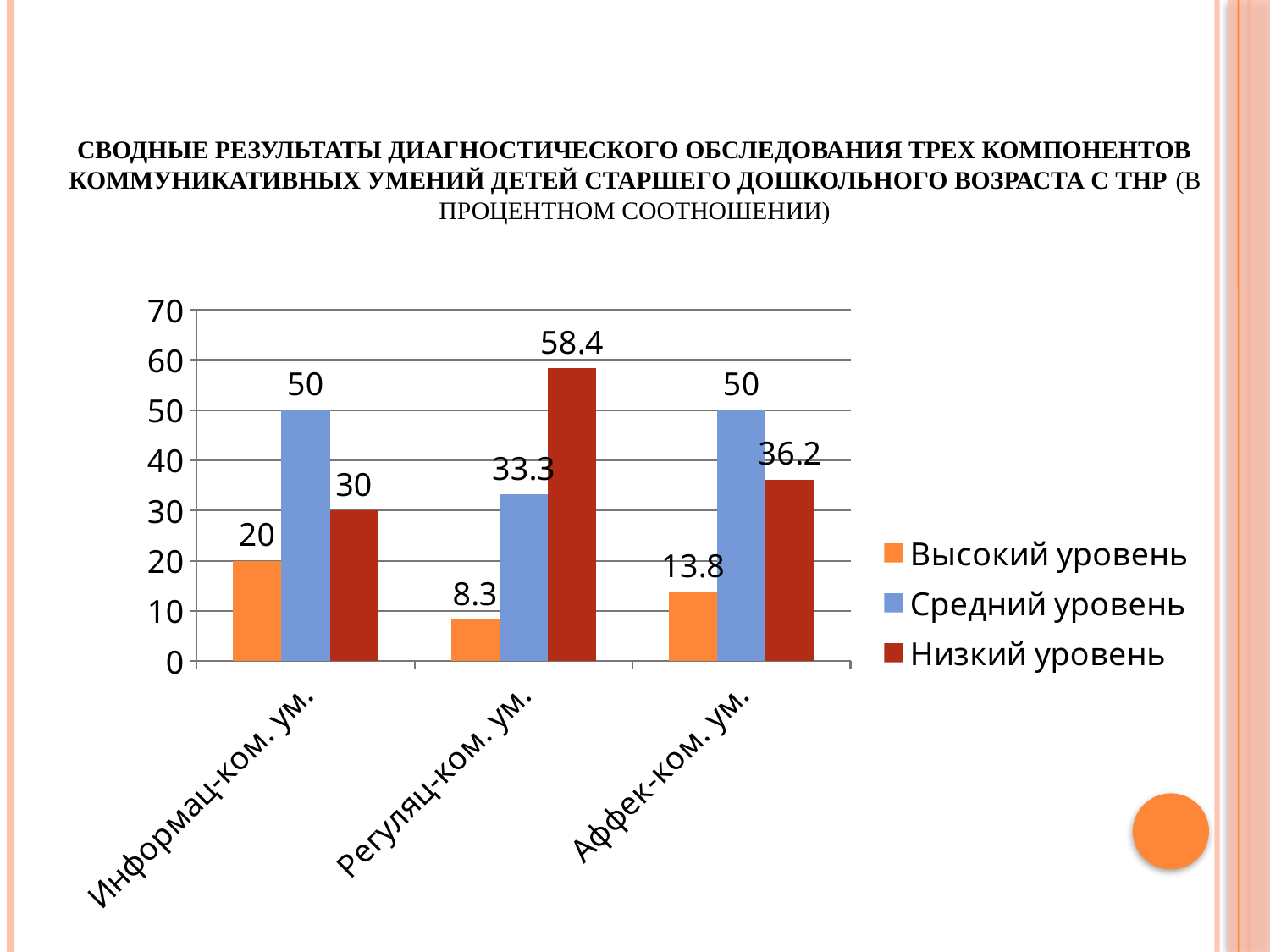
What is the value of Высокий уровень for Аффек-ком. ум.? 13.8 What is the value of Средний уровень for Аффек-ком. ум.? 50 What is the value of Низкий уровень for Регуляц-ком. ум.? 58.4 How many series does the legend list? 3 What is the value of Высокий уровень for Информац-ком. ум.? 20 Which colour represents Низкий уровень in the legend? Dark red Which category has the highest value for Низкий уровень? Регуляц-ком. ум. How many categories are shown on the x axis? 3 What is the difference between Низкий уровень and Средний уровень for Регуляц-ком. ум.? 25.1 Which category has the lowest value for Высокий уровень? Регуляц-ком. ум. What kind of chart is shown on the slide? Bar chart For Аффек-ком. ум., which is larger: Средний уровень or Низкий уровень? Средний уровень